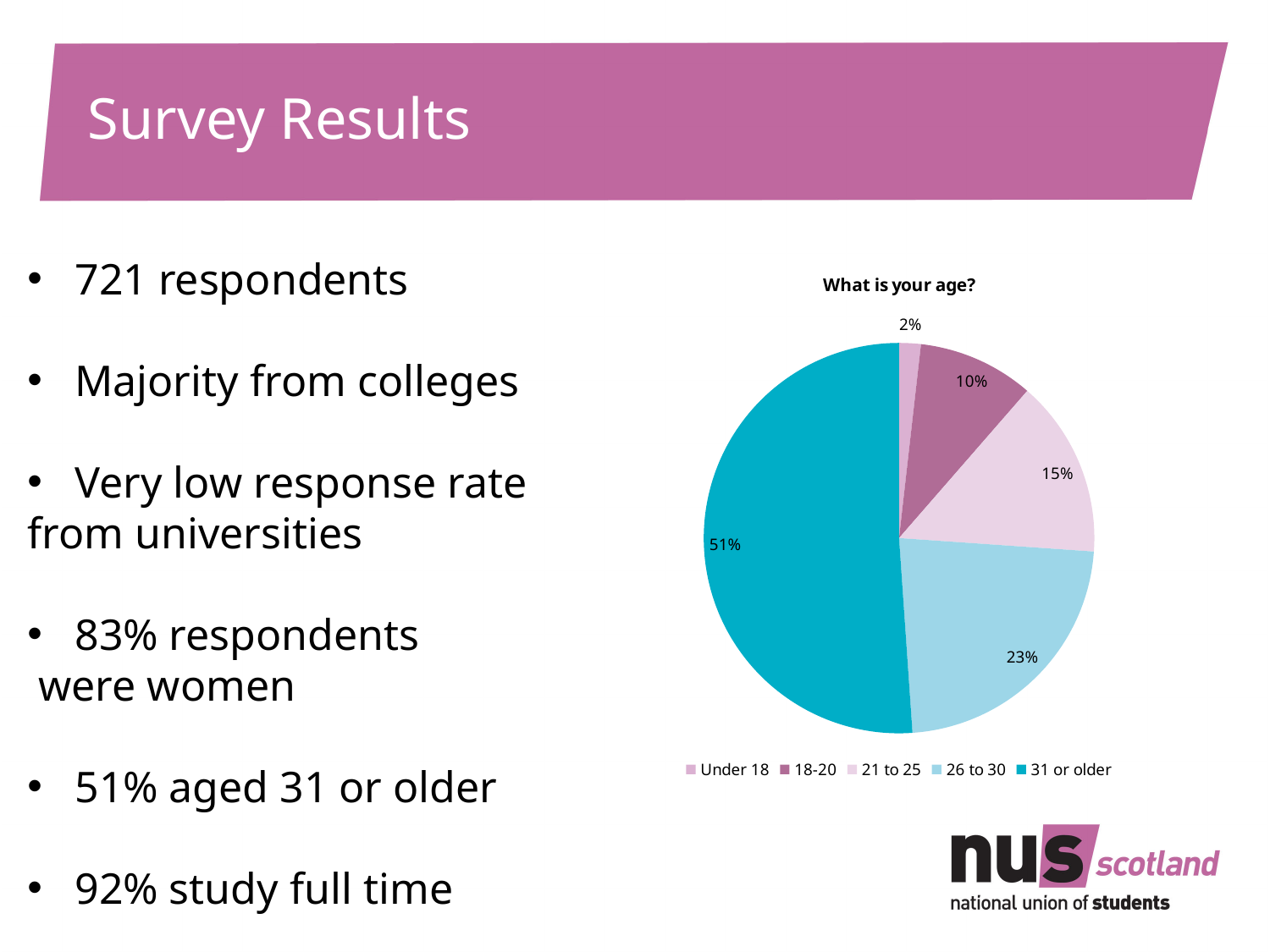
Which is larger, the share for 18-20 or the share for 21 to 25? 21 to 25 What is the difference in percentage points between the 26 to 30 group and the 21 to 25 group? 8 Which age group has the smallest share of the pie? Under 18 What share of respondents are under 18? 2% How many age categories does the legend list? 5 What share of respondents are aged 26 to 30? 23% What type of chart is shown on the slide? pie chart What share of respondents are aged 18-20? 10% What is the title of the chart? What is your age? What share of respondents are aged 21 to 25? 15% What share of respondents are aged 31 or older? 51% Which age group has the largest share of the pie? 31 or older